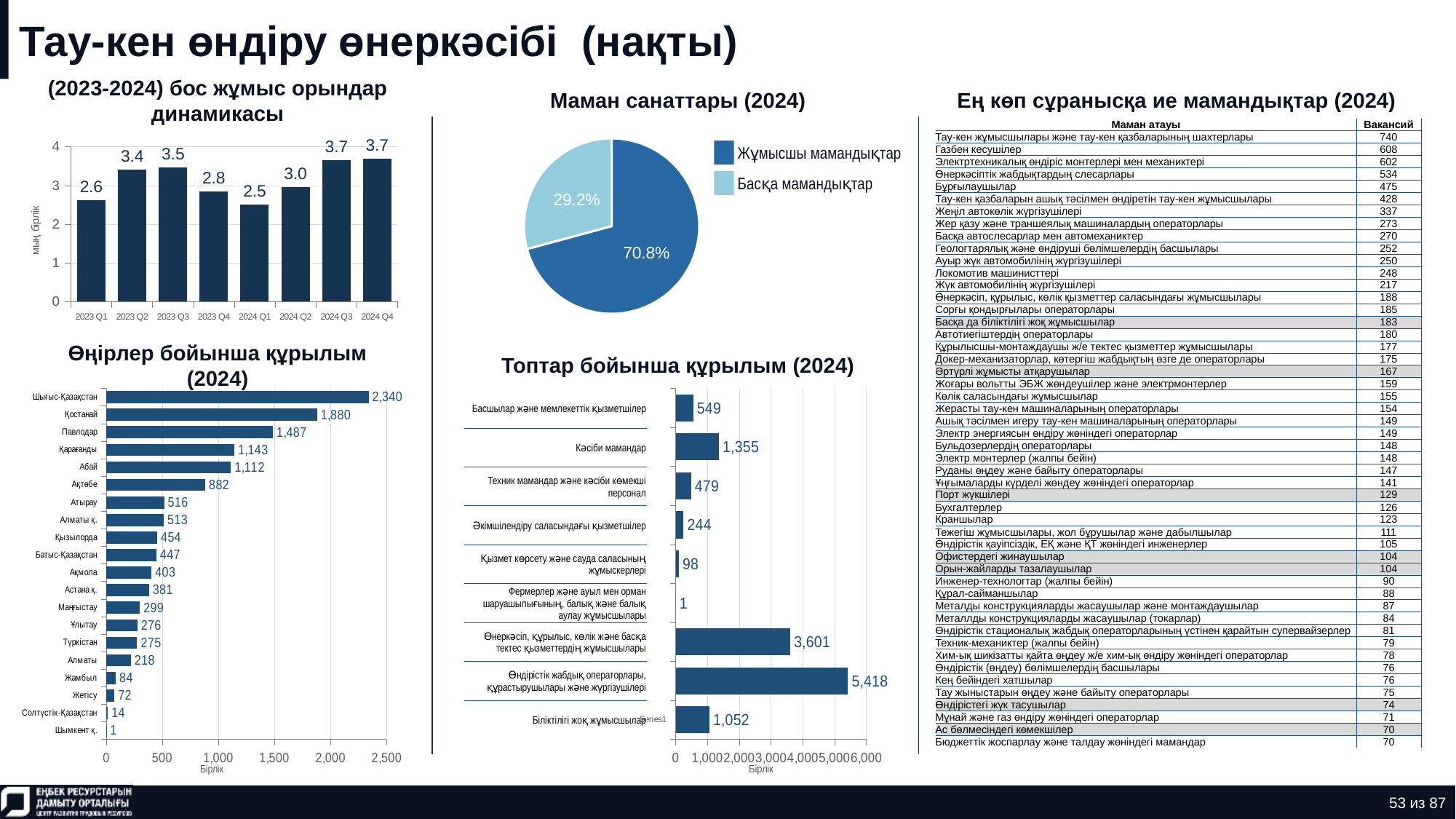
In the chart "(2023-2024) бос жұмыс орындар динамикасы", which quarter has the lowest value? 2024 Q1 What kind of chart is "Маман санаттары (2024)"? pie chart In the chart "Өңірлер бойынша құрылым (2024)", which region has the highest value? Шығыс-Қазақстан In the chart "(2023-2024) бос жұмыс орындар динамикасы", how many quarters are plotted? 8 In the chart "(2023-2024) бос жұмыс орындар динамикасы", what is the difference between 2023 Q2 and 2023 Q1? 0.8 In the chart "Өңірлер бойынша құрылым (2024)", which is larger, Атырау or Алматы қ.? Атырау In the chart "Топтар бойынша құрылым (2024)", what is the value for "Кәсіби мамандар"? 1,355 In the chart "Өңірлер бойынша құрылым (2024)", what is the value for Қарағанды? 1,143 In the pie chart "Маман санаттары (2024)", what share does "Жұмысшы мамандықтар" have? 70.8% In the chart "Топтар бойынша құрылым (2024)", what is the difference between "Өндірістік жабдық операторлары, құрастырушылары және жүргізушілері" and "Өнеркәсіп, құрылыс, көлік және басқа тектес қызметтердің жұмысшылары"? 1,817 In the pie chart "Маман санаттары (2024)", how many categories does the legend list? 2 In the chart "(2023-2024) бос жұмыс орындар динамикасы", what is the value for 2023 Q1? 2.6